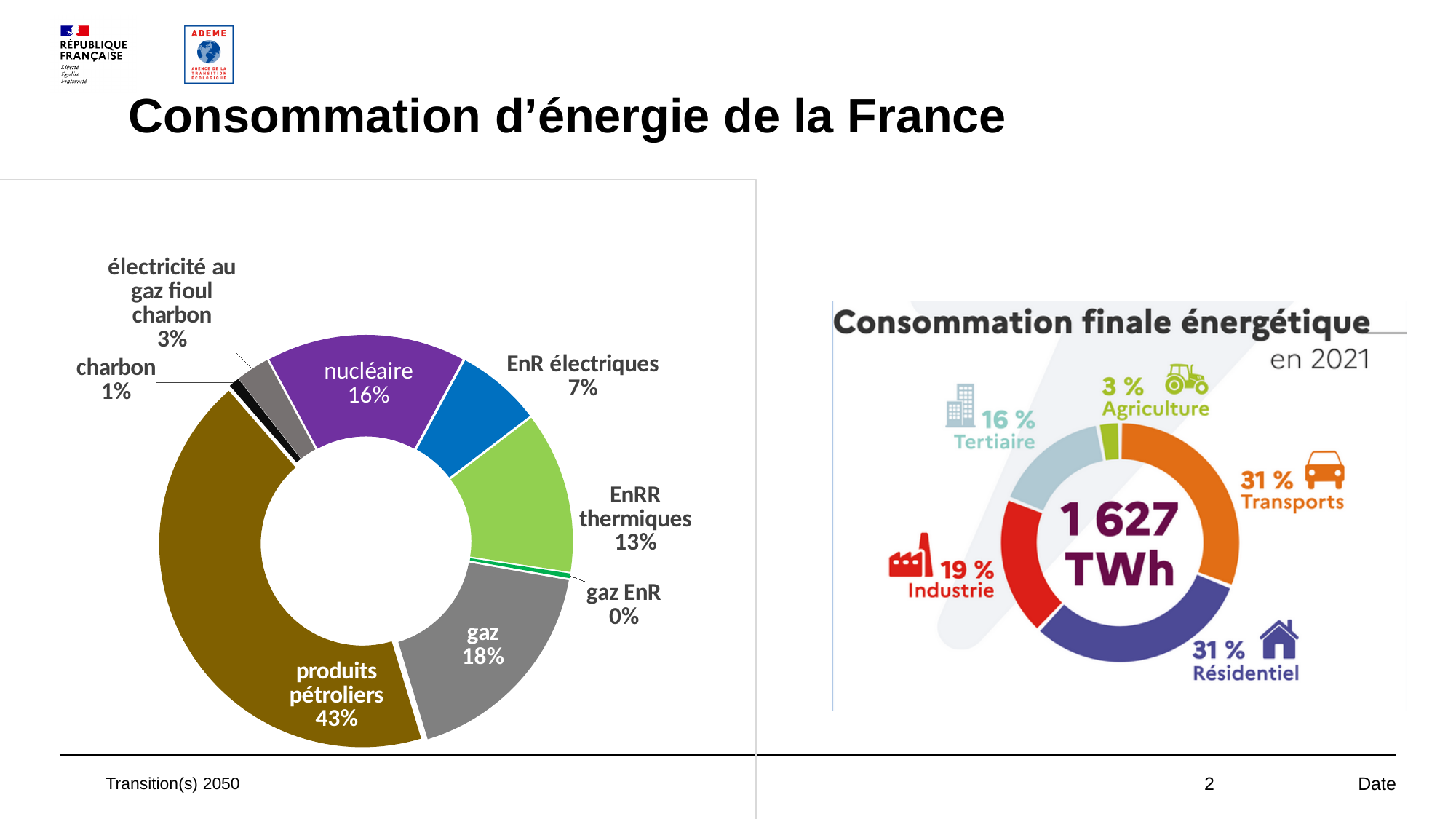
On the left doughnut chart, what share is shown for produits pétroliers? 43% What kind of chart is the left chart on the slide? doughnut (pie) chart On the left doughnut chart, which category has the smallest share? gaz EnR On the chart titled 'Consommation finale énergétique en 2021', what share is shown for Industrie? 19 % On the left doughnut chart, what share is shown for nucléaire? 16% On the chart titled 'Consommation finale énergétique en 2021', what total consumption is shown in the centre? 1 627 TWh How many categories are labelled on the left doughnut chart? 8 On the left doughnut chart, which is larger: EnRR thermiques or nucléaire? nucléaire On the left doughnut chart, which category has the largest share? produits pétroliers On the left doughnut chart, what is the difference between the shares of gaz and EnR électriques? 11% How many sectors are shown on the chart titled 'Consommation finale énergétique en 2021'? 5 On the chart titled 'Consommation finale énergétique en 2021', which sector has the smallest share? Agriculture